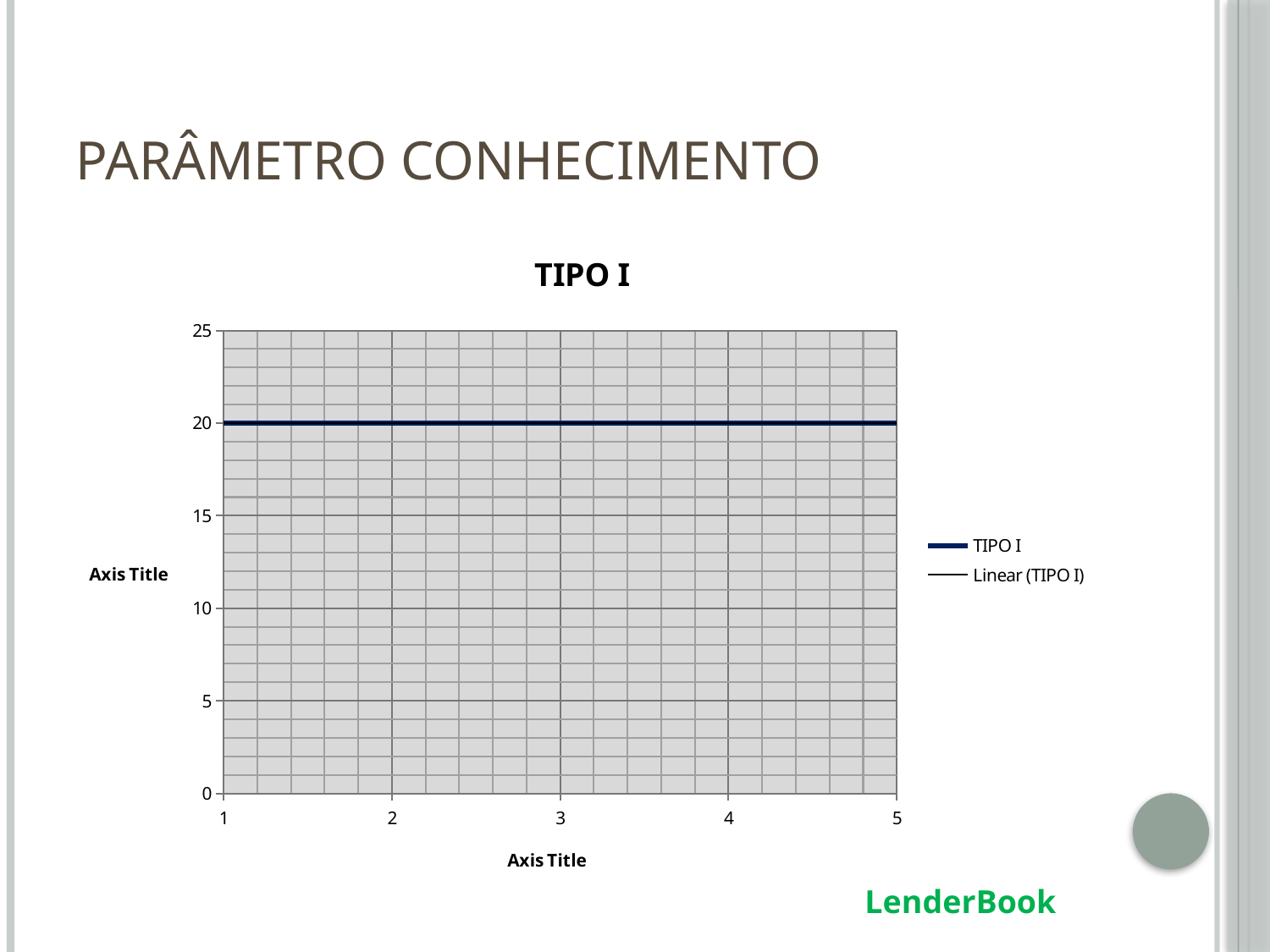
What is the difference between the TIPO I values at x = 1 and x = 5? 0 What is the title of the chart? TIPO I Does the TIPO I line rise, fall, or stay flat from x = 1 to x = 5? stays flat Is the value of the TIPO I series at x = 2 greater or less than 15? greater How many points are labelled along the x axis? 5 What is the value of the TIPO I series at x = 5? 20 What is the value of the TIPO I series at x = 3? 20 How many entries does the chart legend list? 2 What kind of chart is shown on the slide? line chart What is the value of the TIPO I series at x = 1? 20 Is the value of the TIPO I series at x = 4 greater or less than 25? less What is the highest value shown on the y axis? 25